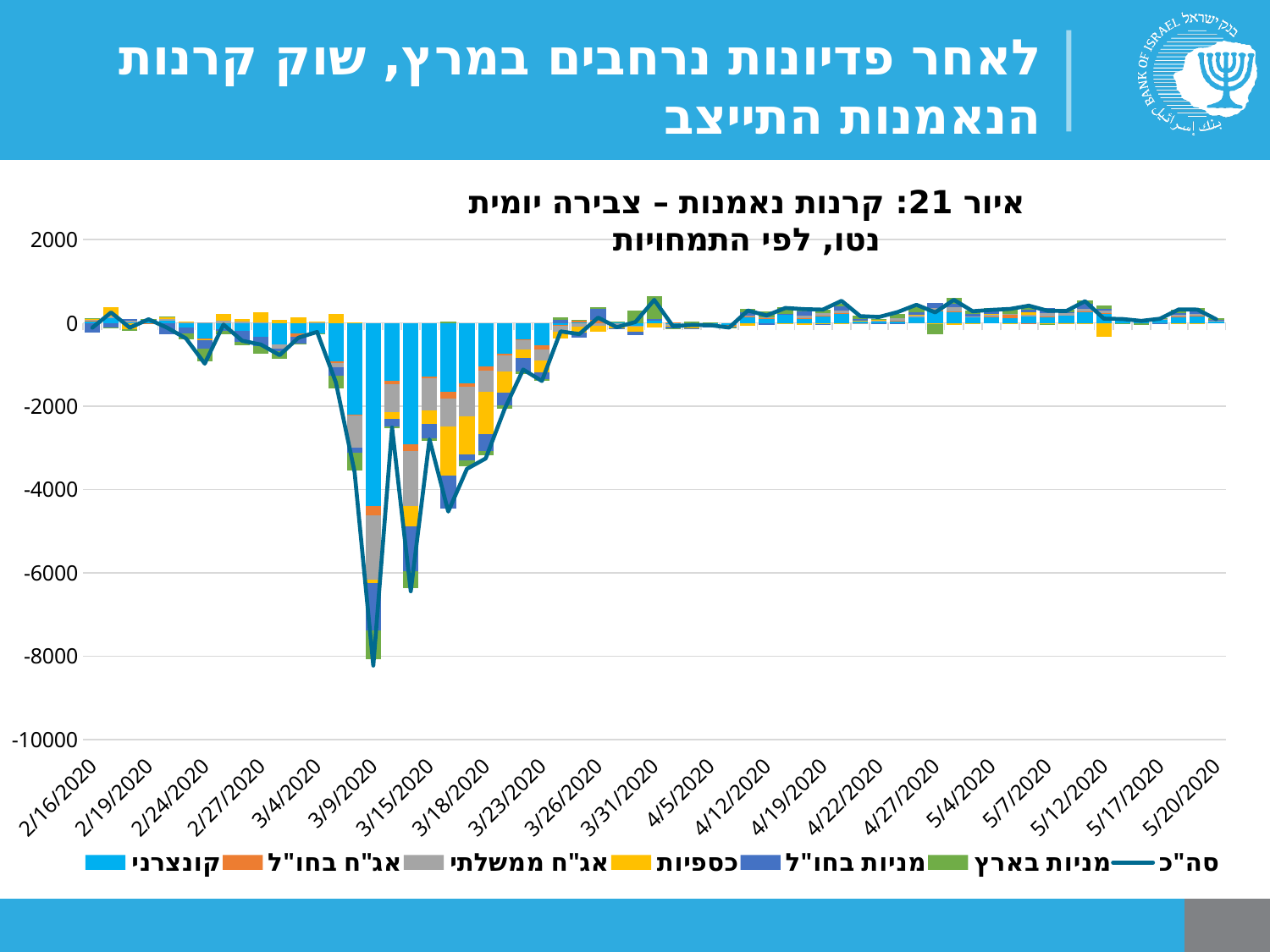
In which month does the סה"כ line reach its lowest point? March 2020 How many entries does the chart legend list? 7 How many date labels are shown on the x axis? 21 Which is larger, the סה"כ value on 3/9/2020 or on 4/5/2020? 4/5/2020 Is the value of the סה"כ line on 3/9/2020 greater or less than 0? less What kind of chart is shown on the slide? A stacked bar chart with a line Is the highest point of the סה"כ line greater or less than 2000? less Is the lowest point of the סה"כ line greater or less than -6000? less Which legend entry is drawn as a line rather than bars? סה"כ What is the title of the chart? איור 21: קרנות נאמנות - צבירה יומית נטו, לפי התמחויות After the low point in mid-March 2020, does the סה"כ line rise or fall toward the end of the period? rise